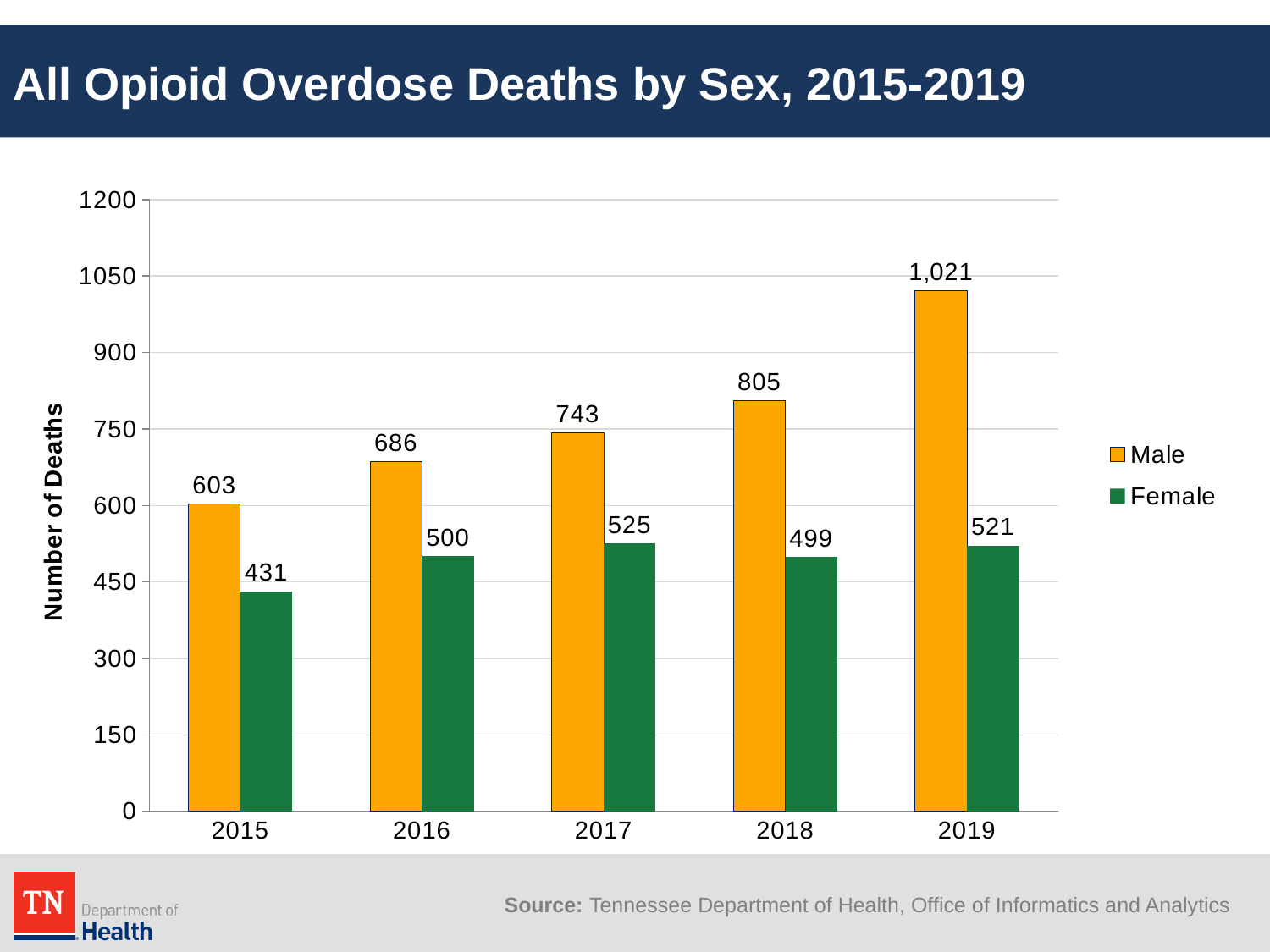
What is the number of male opioid overdose deaths in 2019? 1,021 How many years are shown on the x axis? 5 Which is larger, female deaths in 2017 or female deaths in 2019? Female deaths in 2017 What is the number of female opioid overdose deaths in 2015? 431 What is the number of male opioid overdose deaths in 2017? 743 What is the difference between male and female opioid overdose deaths in 2018? 306 What is the label of the y axis? Number of Deaths How many series does the legend list? 2 In which year were male opioid overdose deaths highest? 2019 Do male opioid overdose deaths rise or fall from 2015 to 2019? Rise In which year were female opioid overdose deaths lowest? 2015 What kind of chart is shown on the slide? Bar chart